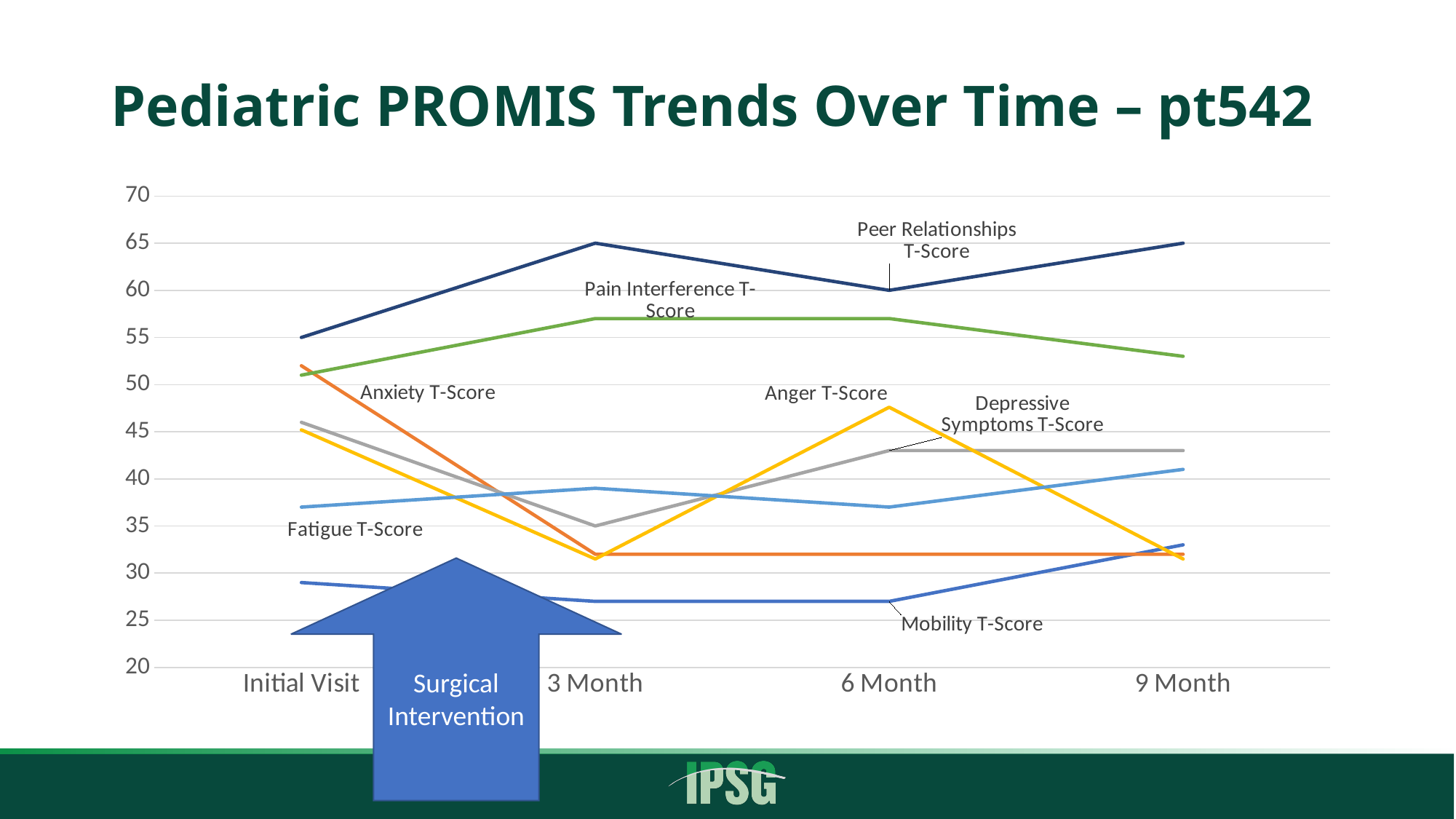
Is the Mobility T-Score at 3 Month greater or less than 30? less How many time points are shown on the x axis? 4 Which series has the highest value at 9 Month? Peer Relationships T-Score What is the Peer Relationships T-Score at the Initial Visit? 55 What kind of chart is shown on the slide? line chart Is the Pain Interference T-Score at 9 Month greater or less than 50? greater Does the Anxiety T-Score rise or fall from the Initial Visit to 3 Month? fall What is the Peer Relationships T-Score at 3 Month? 65 At 3 Month, which is higher: the Peer Relationships T-Score or the Pain Interference T-Score? Peer Relationships T-Score Which series has the lowest value at the Initial Visit? Mobility T-Score How many T-Score series are labelled on the chart? 7 What event does the blue arrow on the chart mark between the Initial Visit and 3 Month? Surgical Intervention